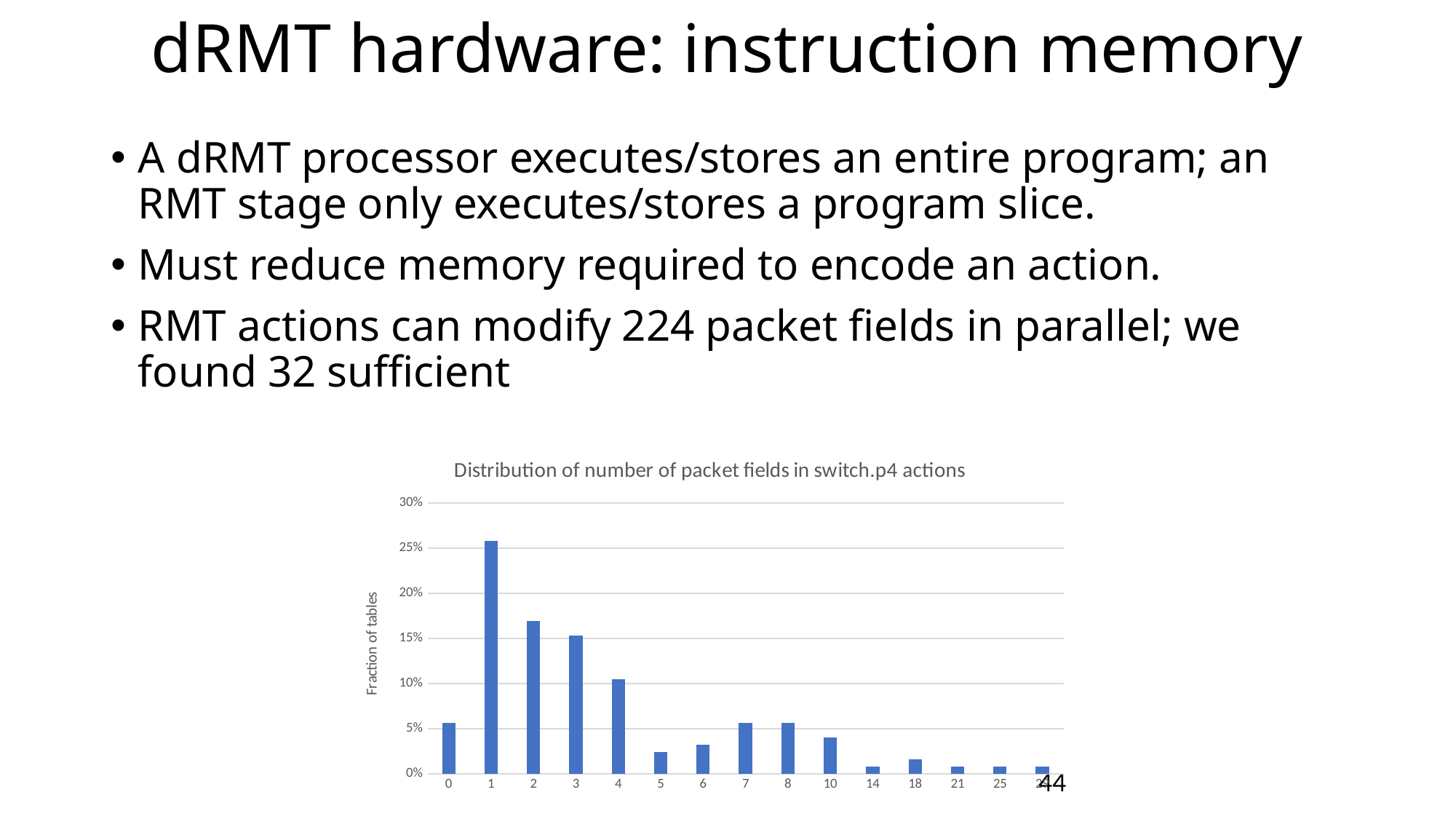
What is the label on the vertical axis of the chart? Fraction of tables Which category on the x axis has the highest fraction of tables? 1 What is the title of the chart? Distribution of number of packet fields in switch.p4 actions Is the value for category 2 greater or less than 15%? greater What kind of chart is shown on the slide? bar chart Is the value for category 5 greater or less than 5%? less Which has a larger fraction of tables, category 4 or category 5? 4 Is the value for category 10 greater or less than 5%? less Moving from category 1 to category 5 along the x axis, do the values rise or fall? fall Which has a larger fraction of tables, category 2 or category 3? 2